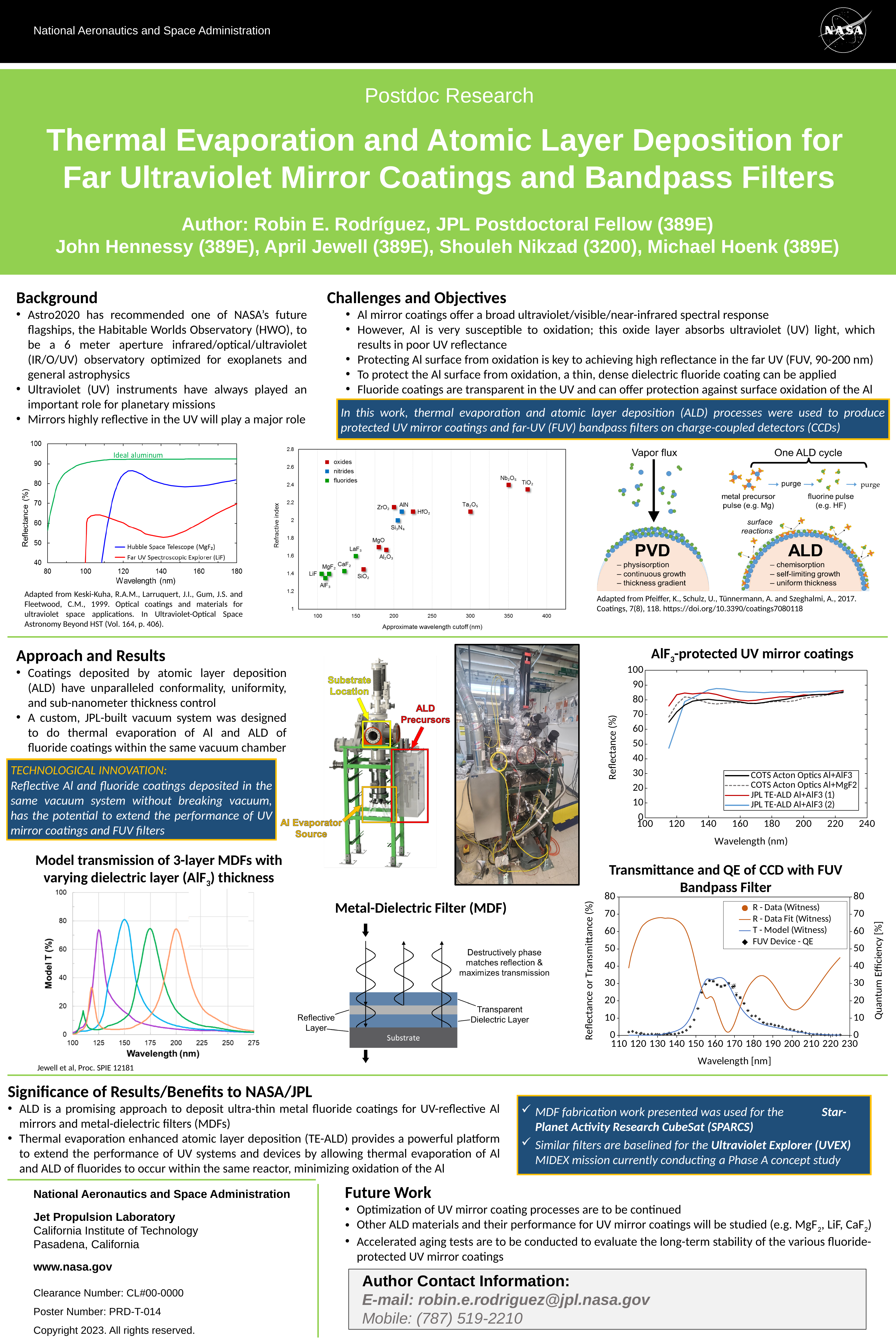
On the 'Transmittance and QE of CCD with FUV Bandpass Filter' chart, how many series does the legend list? 4 On the 'Transmittance and QE of CCD with FUV Bandpass Filter' chart, is the peak of the R - Data Fit (Witness) curve greater or less than 60? greater On the 'AlF3-protected UV mirror coatings' chart, how many series does the legend list? 4 On the top-left reflectance versus wavelength chart, how many entries does the legend list? 2 On the 'Transmittance and QE of CCD with FUV Bandpass Filter' chart, what is the label of the right-hand y axis? Quantum Efficiency [%] On the top-left reflectance versus wavelength chart, is the reflectance of the Ideal aluminum curve at 140 nm greater or less than 90? greater On the 'AlF3-protected UV mirror coatings' chart, is the reflectance for COTS Acton Optics Al+MgF2 at 160 nm greater or less than 70? greater On the refractive index versus approximate wavelength cutoff chart, which has the larger refractive index, HfO2 or MgF2? HfO2 On the 'AlF3-protected UV mirror coatings' chart, what kind of chart is it? line chart